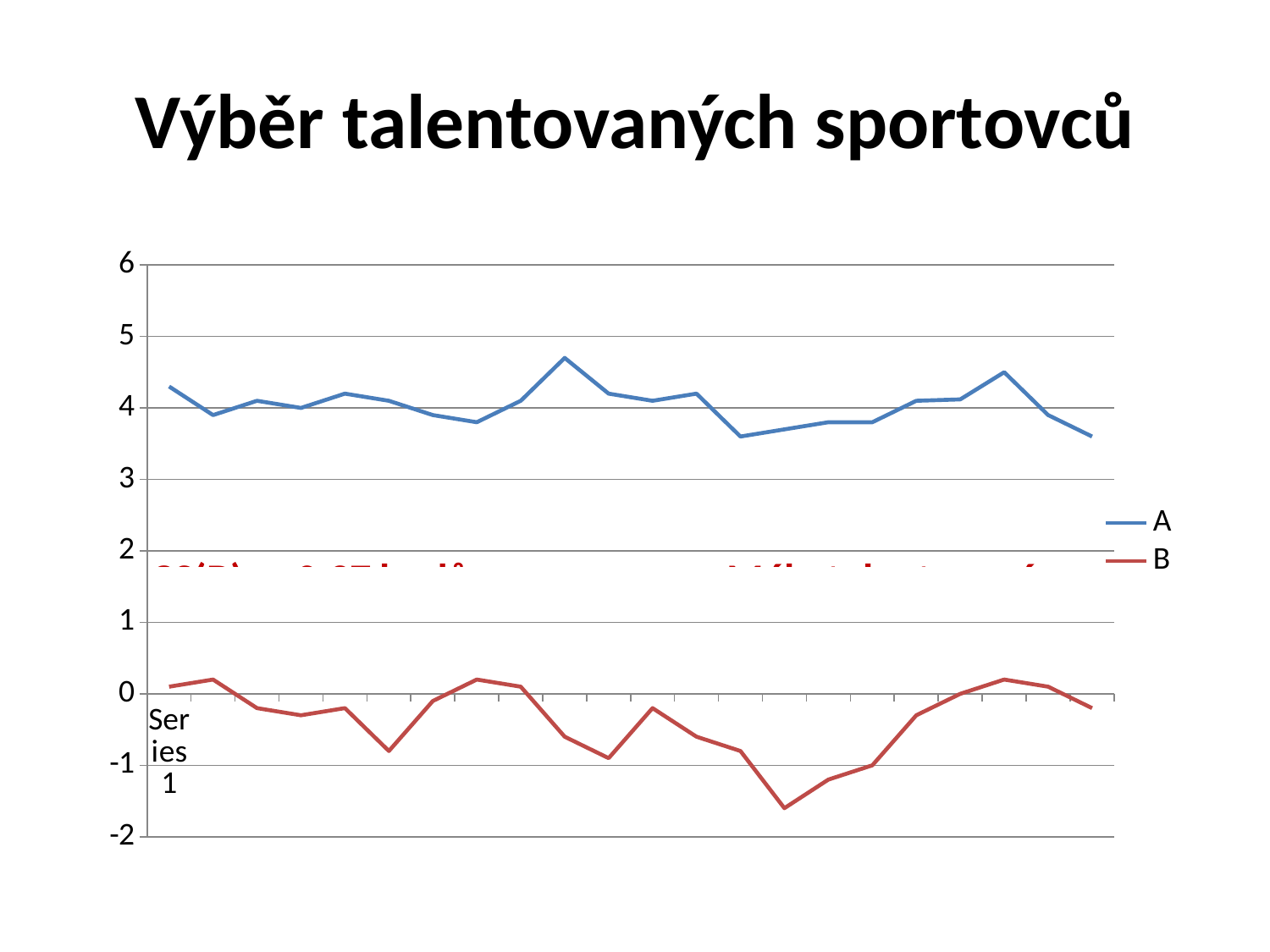
Which series reaches the highest value on the chart? A Is the lowest value of series B greater or less than -1? less Is the value of series A at the first point greater or less than 4? greater What kind of chart is shown on the slide? line chart Which series reaches the lowest value on the chart? B How many series does the legend list? 2 What are the names of the two series in the legend? A and B What is the title of the slide containing the chart? Výběr talentovaných sportovců Is the value of series B at the first point greater or less than 1? less Which series, A or B, has the higher values throughout the chart? A